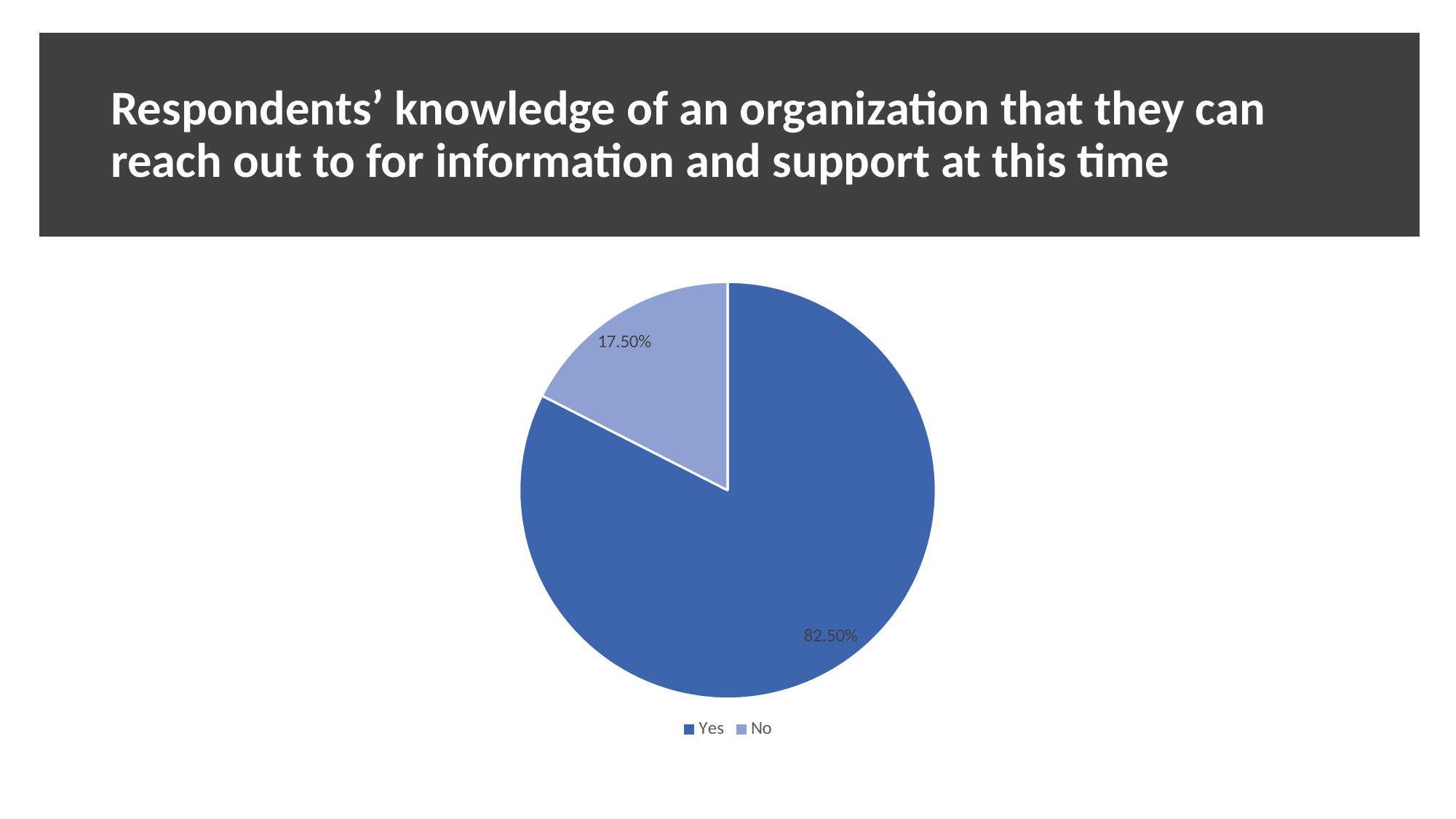
What share of the pie does the No slice represent? 17.50% Which slice is larger, Yes or No? Yes What percentage of respondents answered No? 17.50% What kind of chart is shown on the slide? pie chart How many entries does the legend list? 2 How many categories does the pie chart show? 2 What is the difference in percentage points between the Yes and No slices? 65 percentage points What colour is the Yes slice? dark blue Which category has the largest share of the pie? Yes Which category has the smallest share of the pie? No What percentage of respondents answered Yes? 82.50% Where is the legend positioned relative to the pie? below the pie